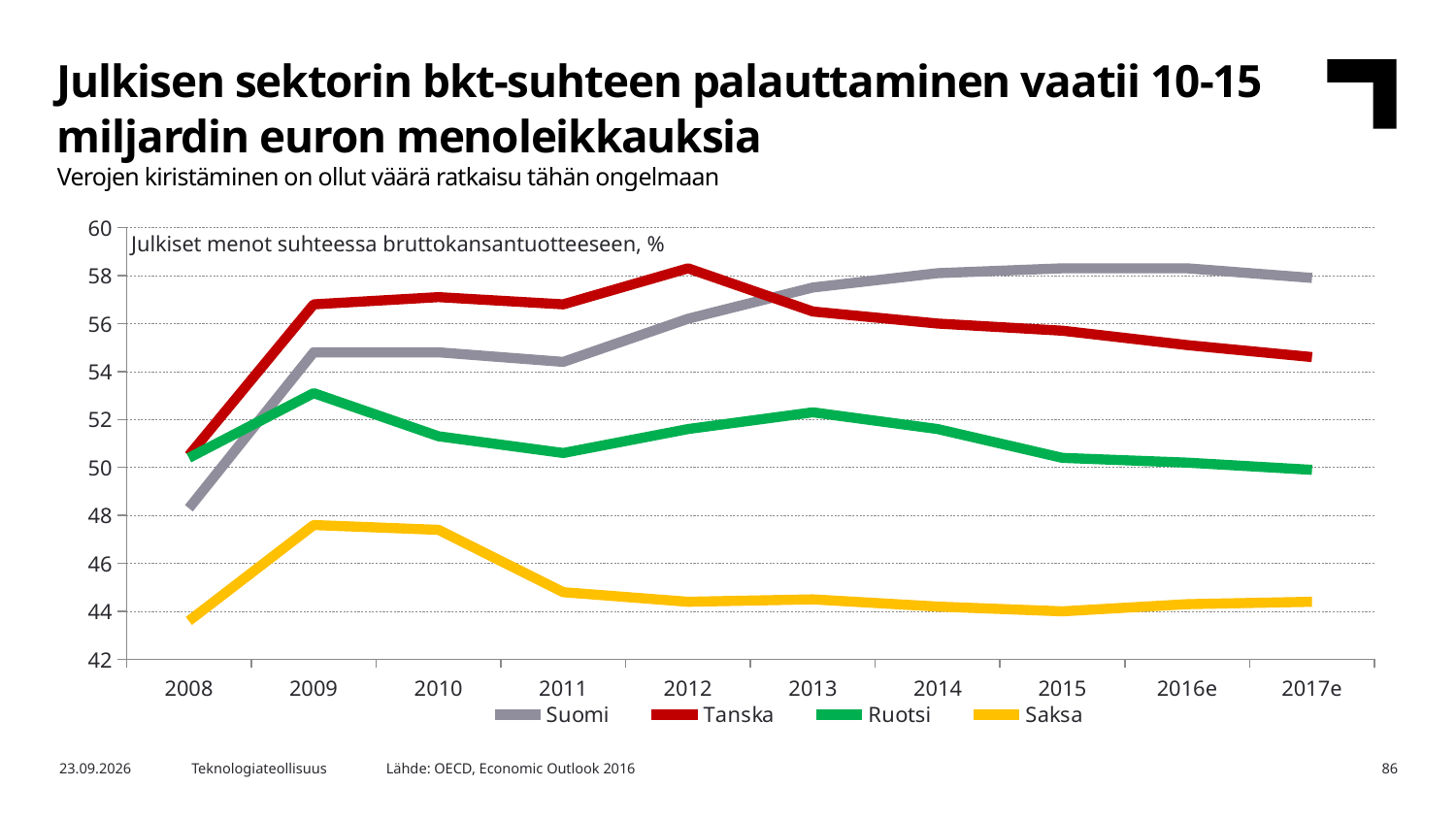
What is the label written inside the plot area at the top of the chart? Julkiset menot suhteessa bruttokansantuotteeseen, % In 2017e, which is higher, Suomi or Tanska? Suomi What kind of chart is shown on the slide? line chart How many series does the legend list? 4 Which series has the lowest value in 2010? Saksa Which series has the highest value in 2017e? Suomi Is the value for Suomi in 2008 greater or less than 50? less How many years are shown on the x axis? 10 Which series has the highest value in 2012? Tanska Is the value for Saksa in 2009 greater or less than 46? greater Does the Tanska line rise or fall from 2012 to 2017e? fall In 2008, which is higher, Tanska or Suomi? Tanska